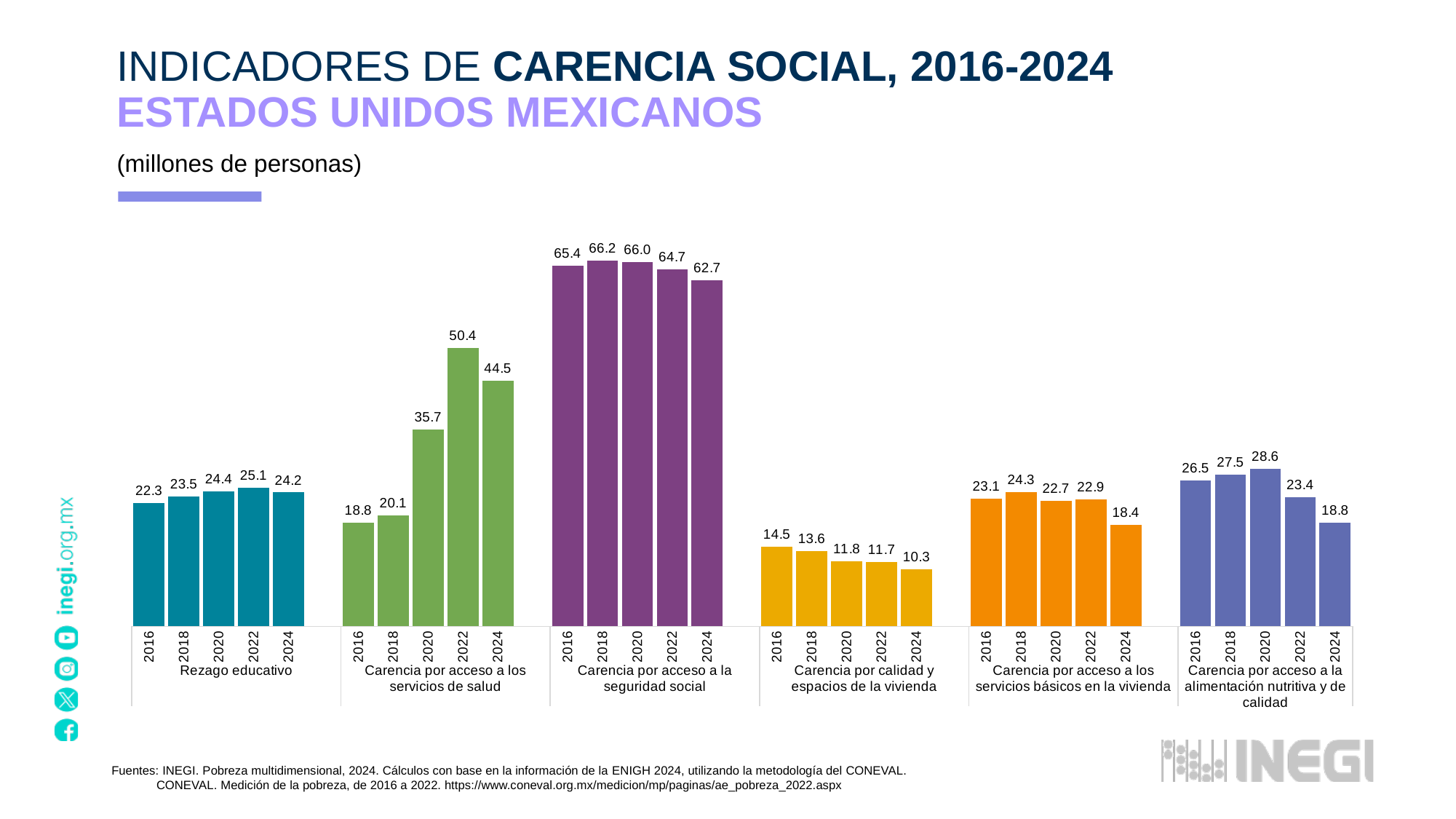
What is the difference between the 2022 and 2016 values for Carencia por acceso a los servicios de salud? 31.6 How many years are shown for each indicator? 5 What is the value for Carencia por acceso a los servicios de salud in 2022? 50.4 How many indicators (categories) are shown on the chart? 6 What kind of chart is shown on the slide? Bar chart Which year has the highest value for Carencia por acceso a la alimentación nutritiva y de calidad? 2020 Which is larger: the 2016 value for Rezago educativo or the 2016 value for Carencia por acceso a los servicios básicos en la vivienda? Carencia por acceso a los servicios básicos en la vivienda What is the value for Carencia por calidad y espacios de la vivienda in 2024? 10.3 Which year has the lowest value for Carencia por acceso a los servicios básicos en la vivienda? 2024 What is the value for Rezago educativo in 2024? 24.2 Do the values for Carencia por calidad y espacios de la vivienda rise or fall from 2016 to 2024? Fall What is the value for Carencia por acceso a la seguridad social in 2018? 66.2